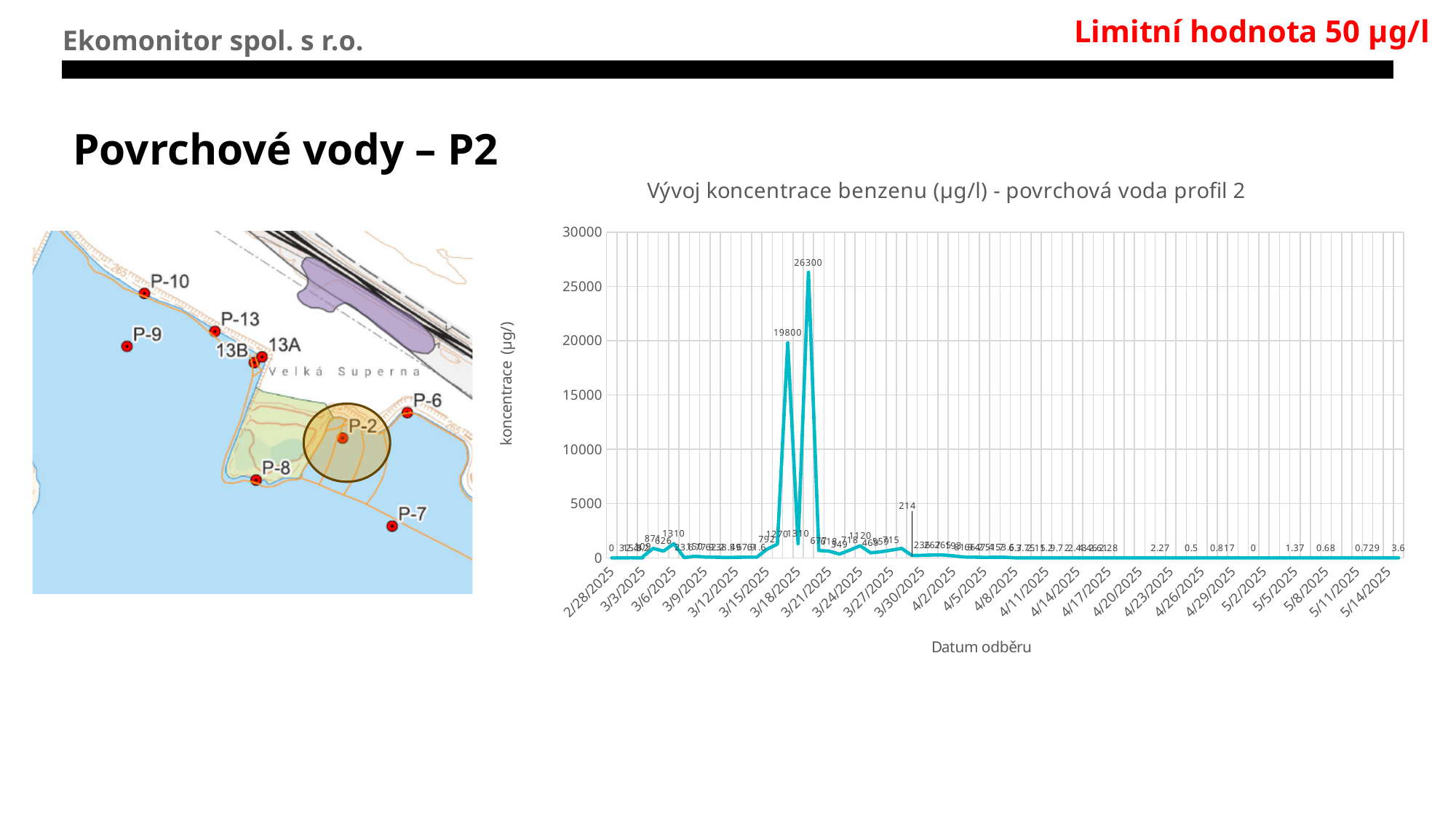
What is the highest tick value shown on the y axis? 30000 What is the labelled value for the last point, 5/14/2025? 3.6 What kind of chart is shown on the slide? line chart What is the label of the x axis of the chart? Datum odběru What is the title of the chart? Vývoj koncentrace benzenu (µg/l) - povrchová voda profil 2 Do the values rise or fall from 3/21/2025 to 5/14/2025? fall Is the value for 5/14/2025 greater or less than 5000? less Which is larger: the peak labelled 26300 or the peak labelled 19800? 26300 What is the difference between the two highest labelled peaks, 26300 and 19800? 6500 What is the highest benzene concentration value labelled on the chart? 26300 What is the value of the second-highest peak labelled on the chart? 19800